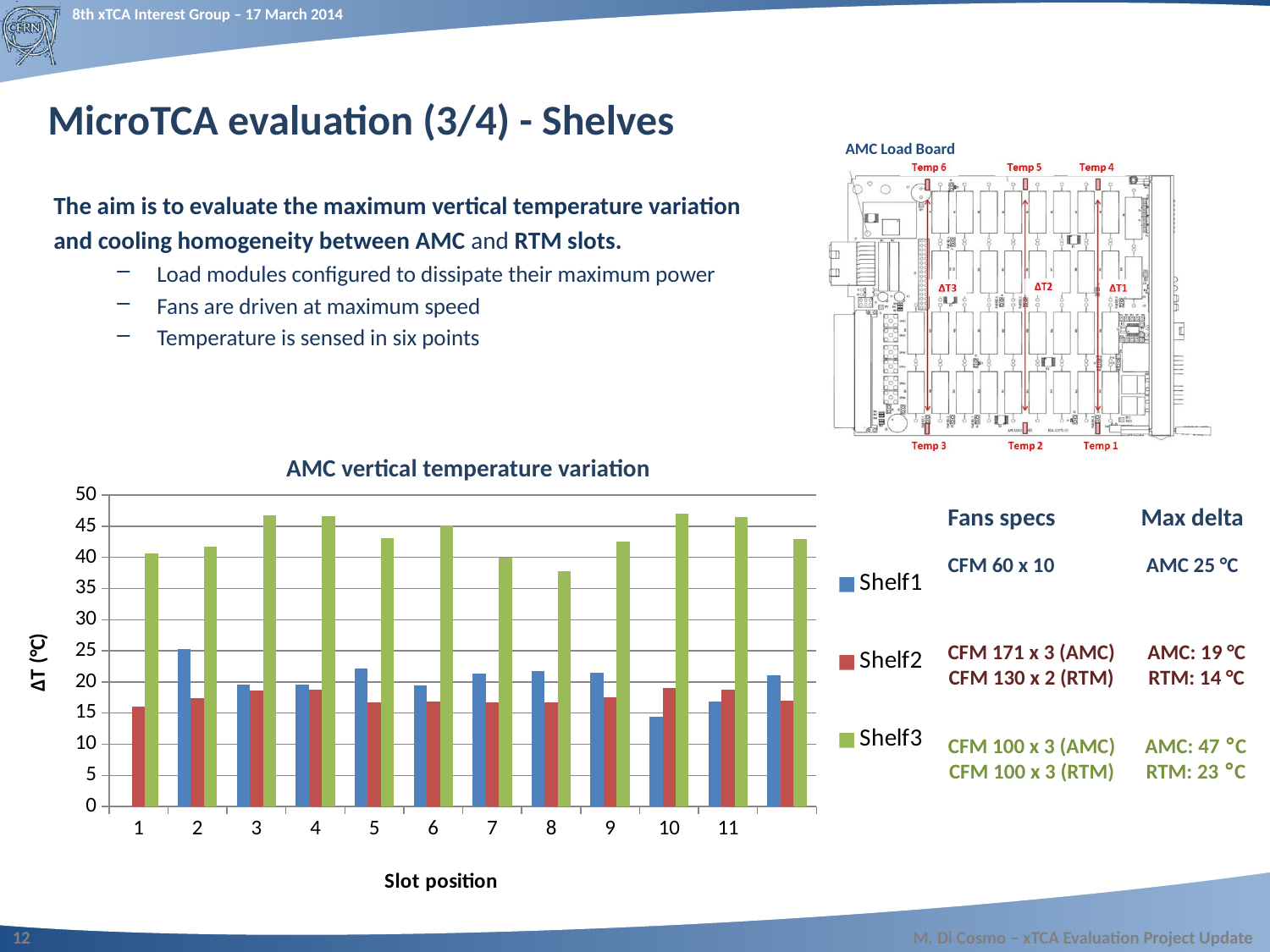
At which slot position is the Shelf1 value highest? 2 At slot position 2, which is larger: Shelf1 or Shelf2? Shelf1 What is the title of the chart on the slide? AMC vertical temperature variation Is the value for Shelf3 at slot position 8 greater or less than 40? less At slot position 10, which is larger: Shelf1 or Shelf2? Shelf2 What kind of chart is "AMC vertical temperature variation"? bar chart Is the value for Shelf3 at slot position 3 greater or less than 45? greater Is the value for Shelf1 at slot position 2 greater or less than 20? greater At which slot position is the Shelf3 value lowest? 8 What is the label of the vertical axis of the chart? ΔT (°C) How many series does the legend of the "AMC vertical temperature variation" chart list? 3 Which series has the highest value at slot position 2? Shelf3